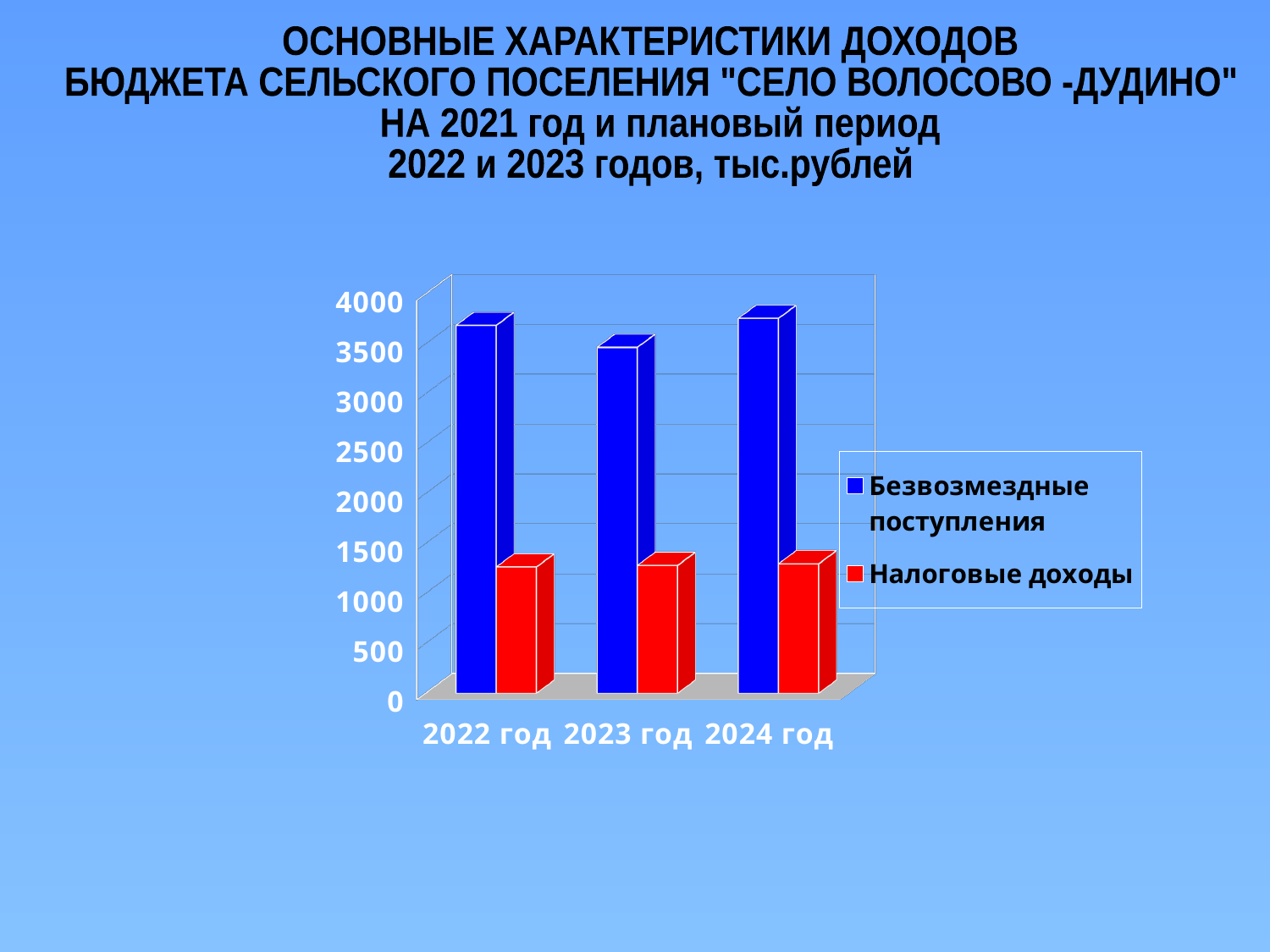
Is the value for Налоговые доходы in 2024 год greater or less than 1000? greater How many series does the legend list? 2 What kind of chart is shown on the slide? bar chart In which year is the value for Безвозмездные поступления lowest? 2023 год Is the value for Безвозмездные поступления in 2022 год greater or less than 3500? greater How many year categories are shown on the x axis? 3 Which is larger: Безвозмездные поступления in 2022 год or in 2023 год? 2022 год Is the value for Безвозмездные поступления in 2024 год greater or less than 3500? greater Which series is shown in blue? Безвозмездные поступления In 2023 год, which is larger: Безвозмездные поступления or Налоговые доходы? Безвозмездные поступления Which series is shown in red? Налоговые доходы